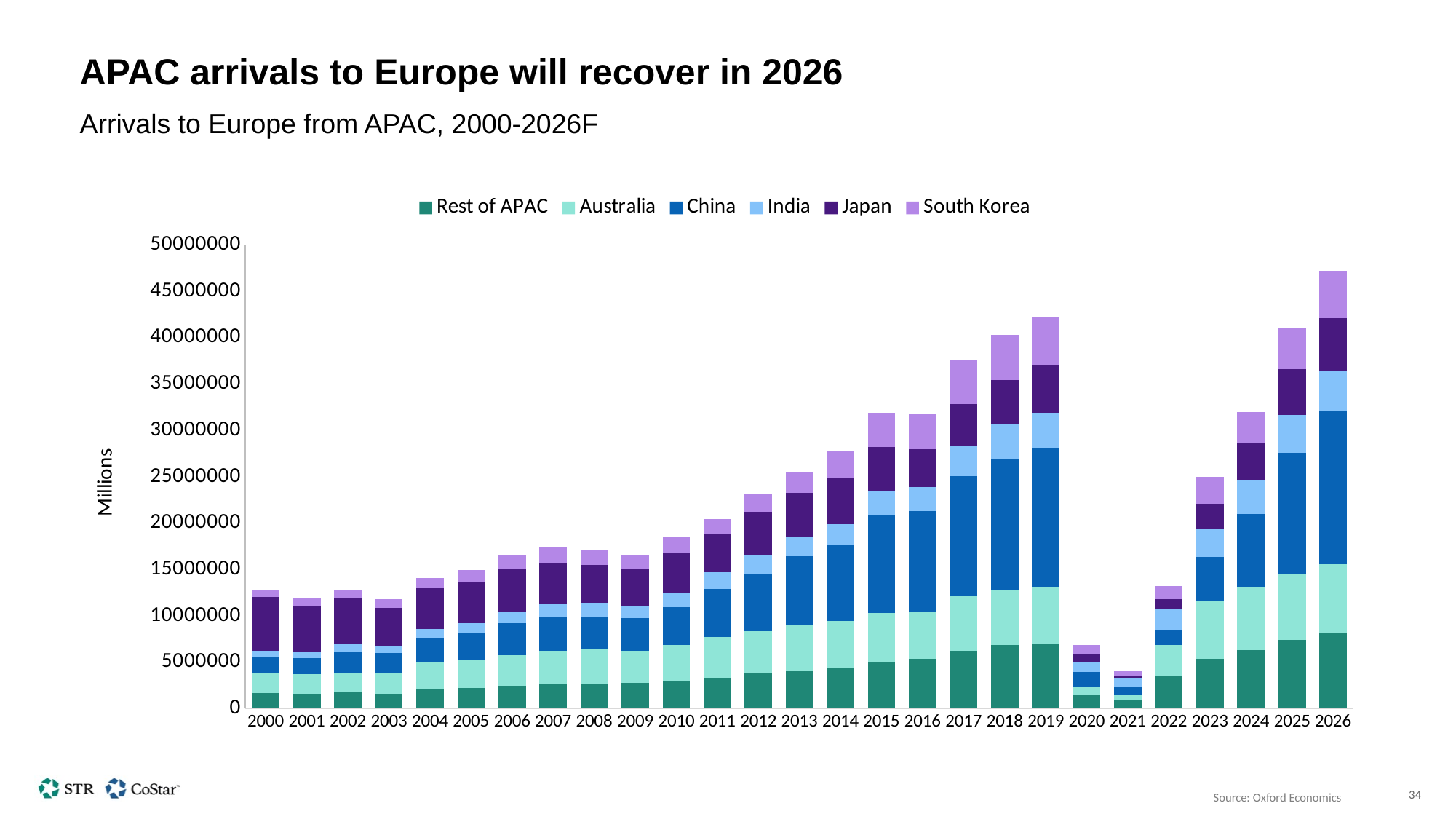
What kind of chart is shown on the slide? Stacked bar chart Do total arrivals rise or fall from 2021 to 2026? Rise Which series is listed first in the legend? Rest of APAC How many years are shown along the x axis? 27 Which year has a larger total, 2023 or 2015? 2015 Is the total for 2020 greater or less than 10000000? less Is the total for 2026 greater or less than 45000000? greater Which year has the lowest total arrivals to Europe from APAC? 2021 How many series does the legend list? 6 Is the total for 2019 greater or less than 40000000? greater What is the label on the y axis? Millions Which year has the highest total arrivals to Europe from APAC? 2026